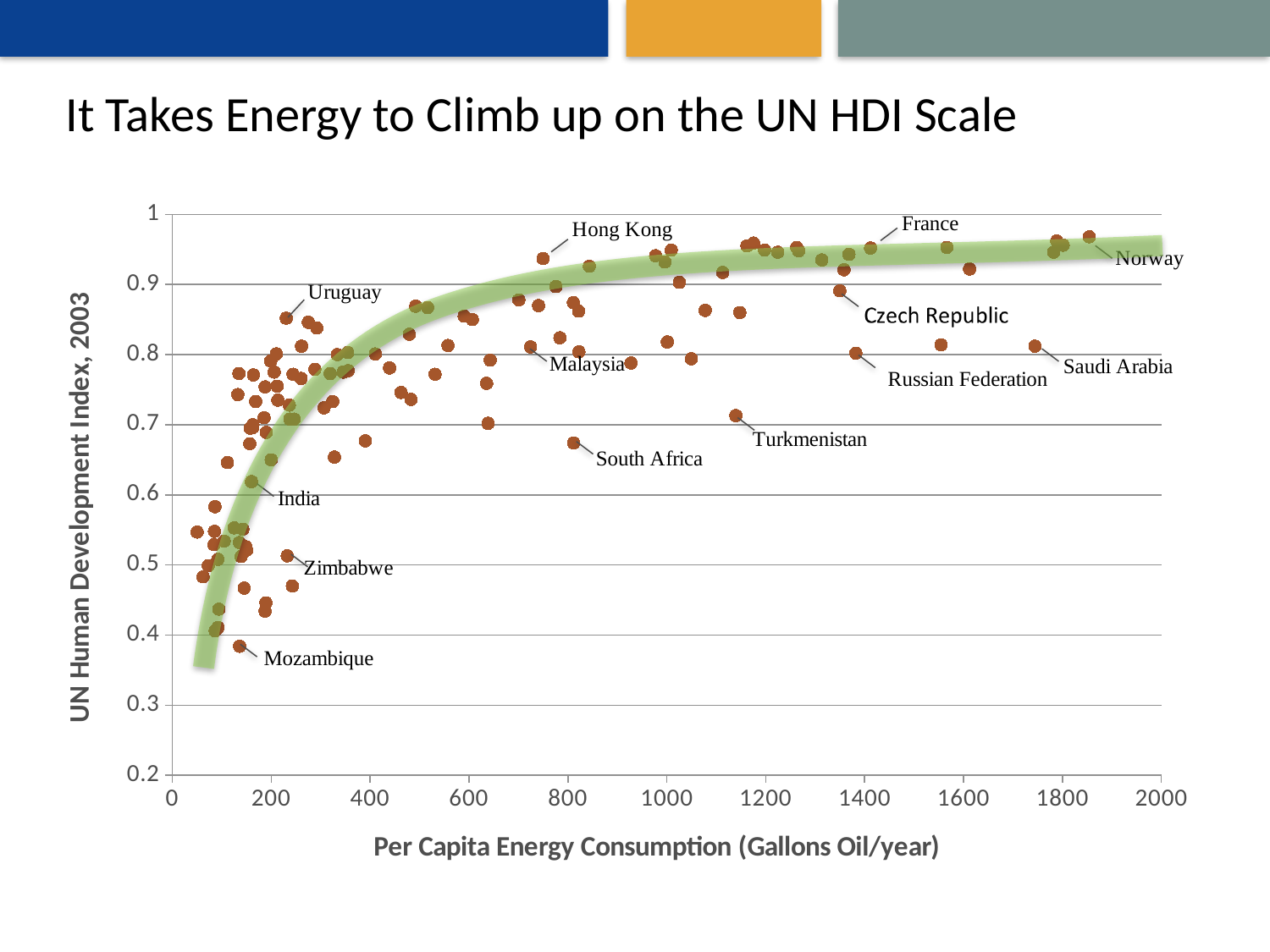
Is the UN Human Development Index value for Saudi Arabia greater or less than 0.9? less Is the per capita energy consumption for Turkmenistan greater or less than 1000 gallons oil/year? greater Is the UN Human Development Index value for Mozambique greater or less than 0.5? less Which has a higher per capita energy consumption, Saudi Arabia or India? Saudi Arabia Which has a higher UN Human Development Index, Norway or Mozambique? Norway What is the title of the x axis? Per Capita Energy Consumption (Gallons Oil/year) What kind of chart is shown on the slide? Scatter chart Does the UN Human Development Index generally rise or fall as per capita energy consumption increases? Rise